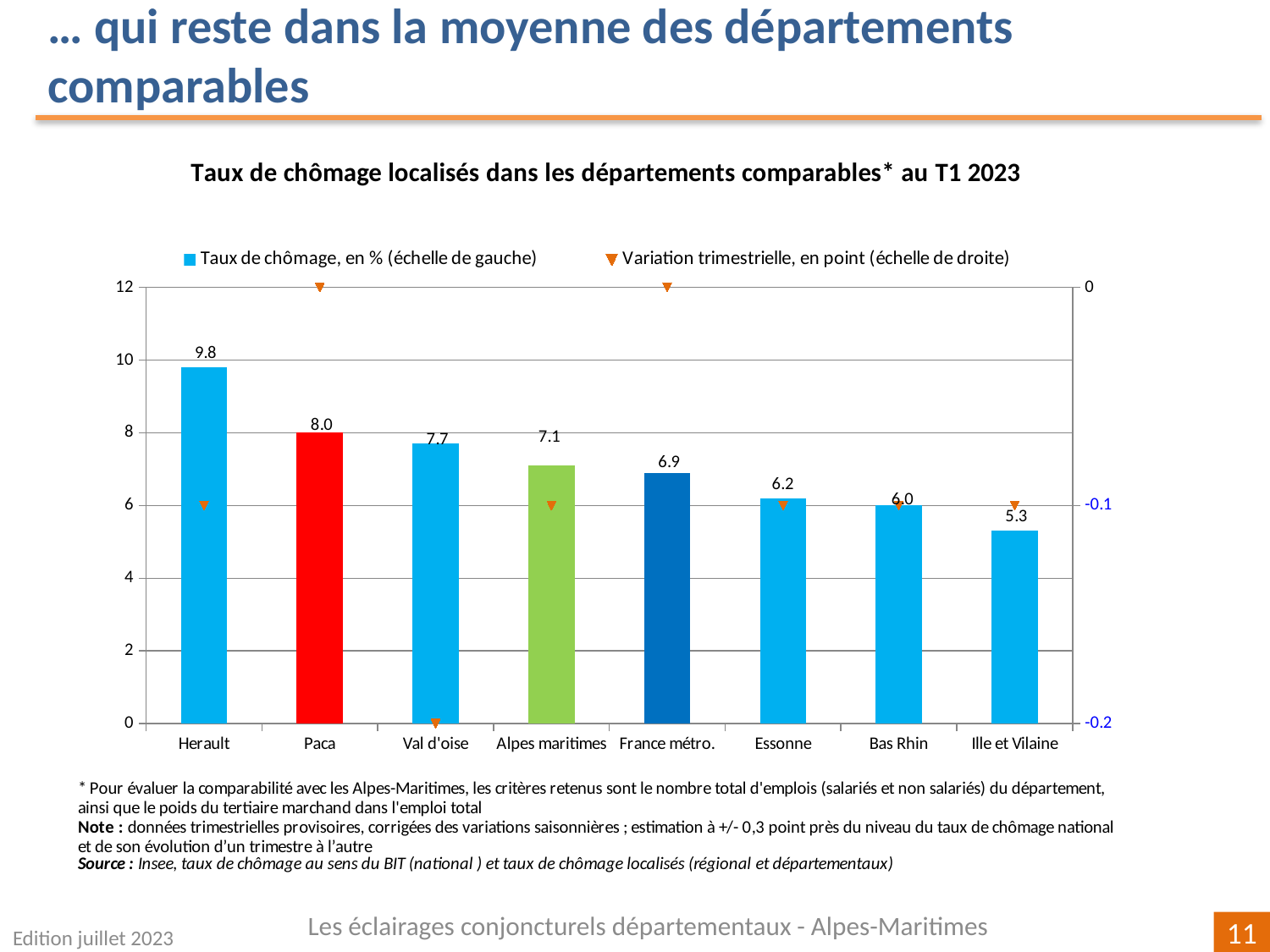
What is the quarterly variation (Variation trimestrielle, en point) for Val d'oise? -0.2 What is the quarterly variation (Variation trimestrielle, en point) for Paca? 0 What is the unemployment rate (Taux de chômage, en %) for Herault? 9.8 How many series does the legend list? 2 What is the unemployment rate (Taux de chômage, en %) for France métro.? 6.9 What is the difference between the unemployment rates of Herault and Paca? 1.8 What is the unemployment rate (Taux de chômage, en %) for Alpes maritimes? 7.1 What is the title of the chart? Taux de chômage localisés dans les départements comparables* au T1 2023 Which has a higher unemployment rate, Essonne or Bas Rhin? Essonne Which category has the highest unemployment rate? Herault Which category has the lowest unemployment rate? Ille et Vilaine How many categories are shown on the x axis? 8